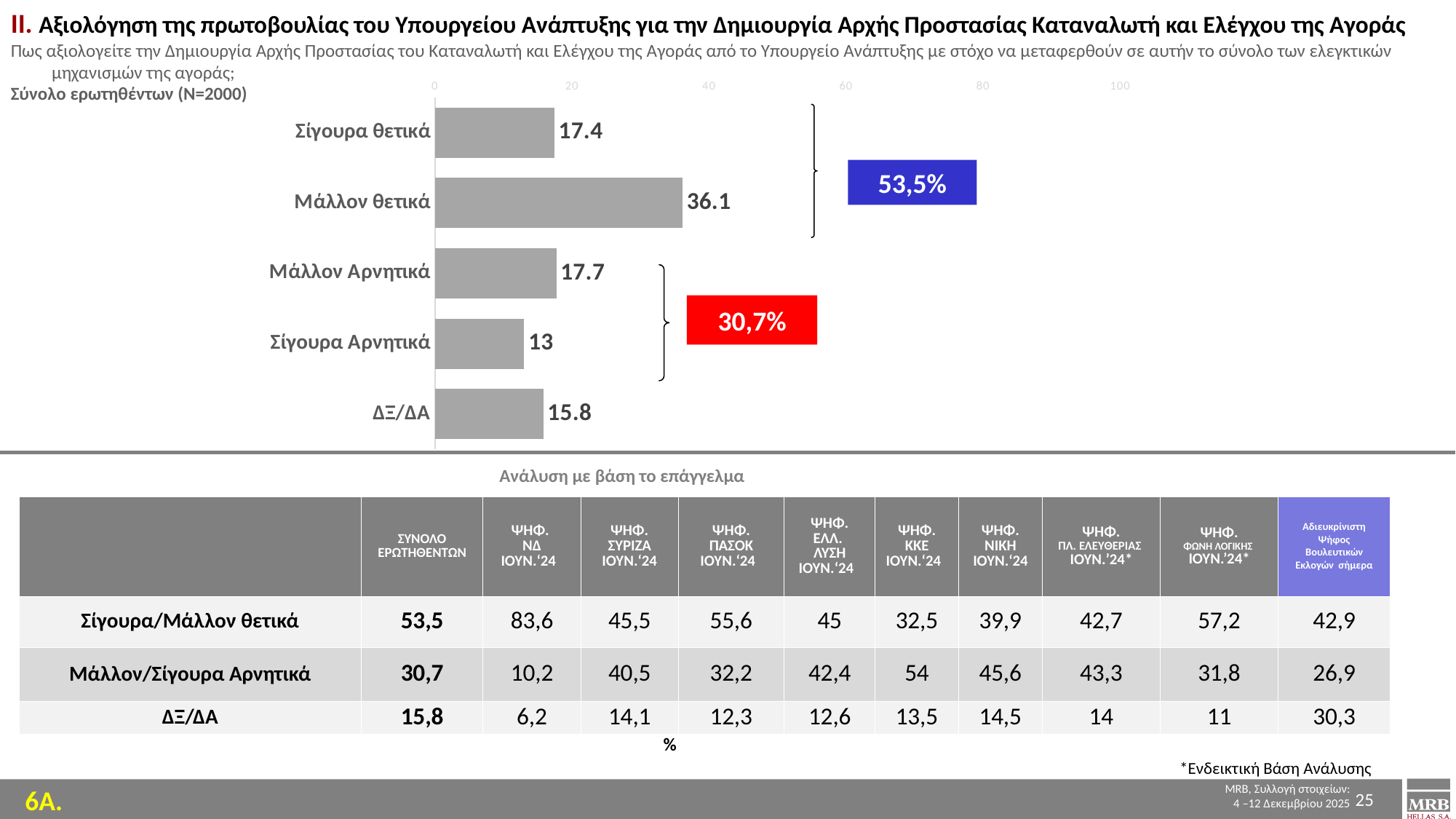
Is the value for "Μάλλον θετικά" in the bar chart greater or less than 40? less What value is shown for "Σίγουρα Αρνητικά" in the bar chart? 13 What value is shown for "Μάλλον θετικά" in the bar chart? 36.1 What value is shown for "ΔΞ/ΔΑ" in the bar chart? 15.8 Which category has the lowest value in the bar chart? Σίγουρα Αρνητικά What combined percentage is shown in the blue box next to the positive categories in the bar chart? 53,5% Which is larger in the bar chart: the value for "Σίγουρα θετικά" or the value for "Σίγουρα Αρνητικά"? Σίγουρα θετικά Which category has the highest value in the bar chart? Μάλλον θετικά What combined percentage is shown in the red box next to the negative categories in the bar chart? 30,7% How many categories are shown in the bar chart? 5 What type of chart is shown on the slide? bar chart What is the difference between the values for "Μάλλον θετικά" and "Σίγουρα θετικά" in the bar chart? 18.7